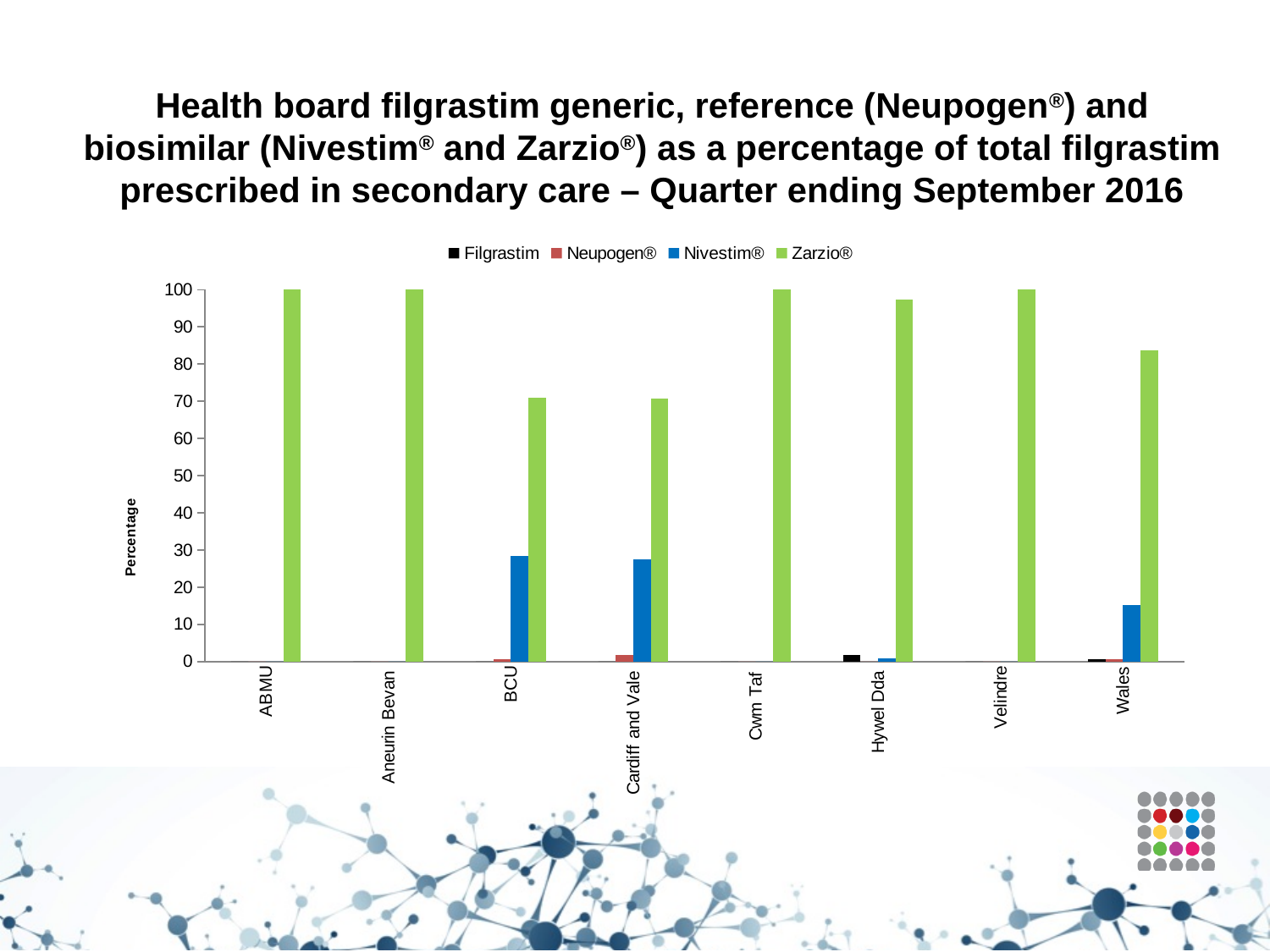
What is the Zarzio® value for ABMU? 100 Is the Nivestim® value for Wales greater or less than 20? less Which series is shown in green in the legend? Zarzio® What kind of chart is shown on the slide? bar chart How many series does the legend list? 4 Which is larger, the Zarzio® value for Hywel Dda or the Zarzio® value for Wales? Hywel Dda Which is larger, the Nivestim® value for BCU or the Nivestim® value for Wales? BCU What is the label on the y axis? Percentage Is the Zarzio® value for Wales greater or less than 90? less Is the Nivestim® value for BCU greater or less than 20? greater How many health board categories are shown on the x axis? 8